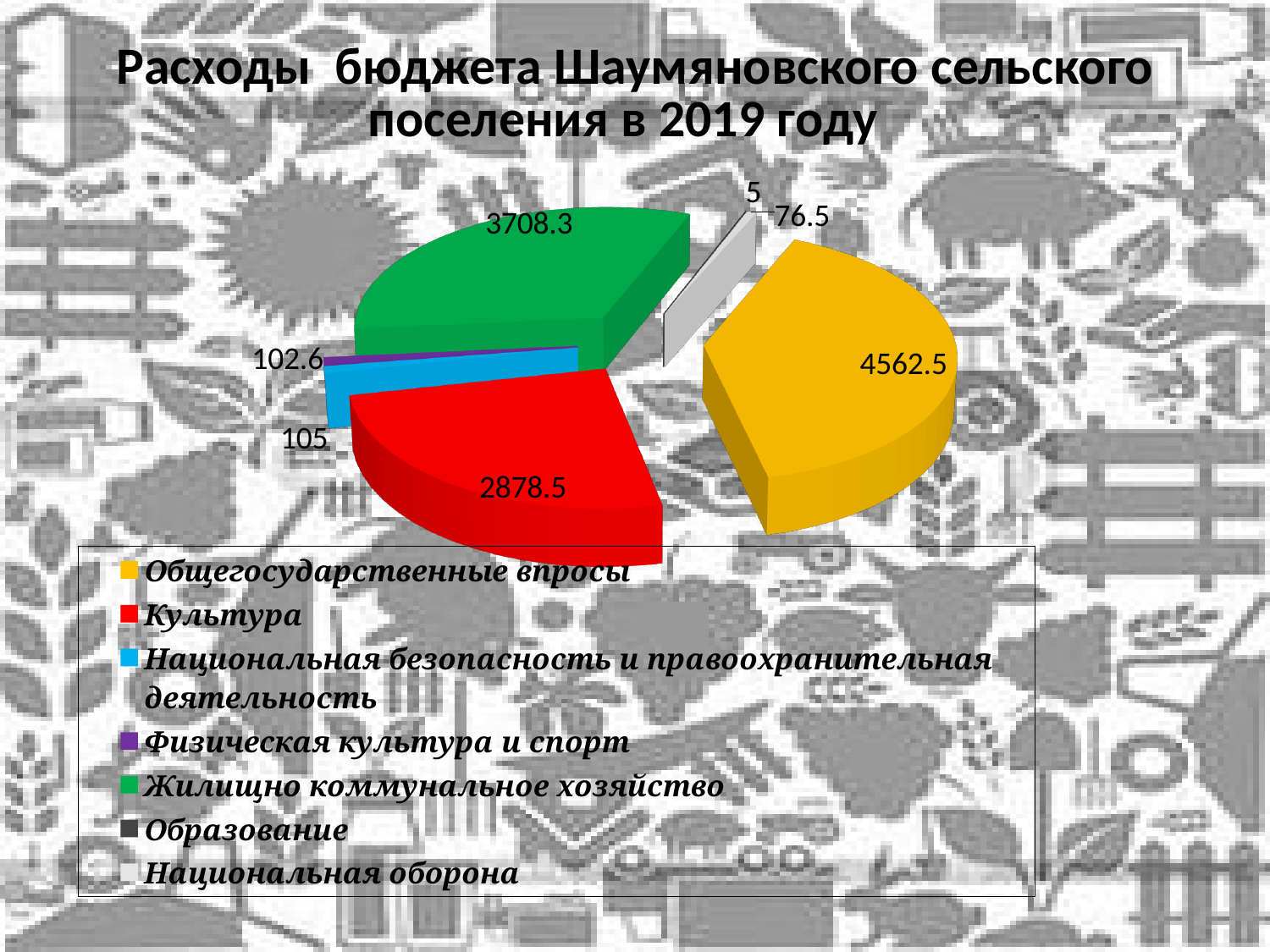
Which category has the largest value? Общегосударственные впросы What is the value for Общегосударственные впросы? 4562.5 What kind of chart is shown on the slide? pie chart What is the value for Национальная оборона? 76.5 How many categories does the legend list? 7 What is the value for Физическая культура и спорт? 102.6 Which category has the smallest value? Образование What is the value for Жилищно коммунальное хозяйство? 3708.3 What is the difference between the values for Общегосударственные впросы and Жилищно коммунальное хозяйство? 854.2 What is the value for Культура? 2878.5 What is the title of the chart? Расходы бюджета Шаумяновского сельского поселения в 2019 году Which is larger, the value for Культура or the value for Жилищно коммунальное хозяйство? Жилищно коммунальное хозяйство